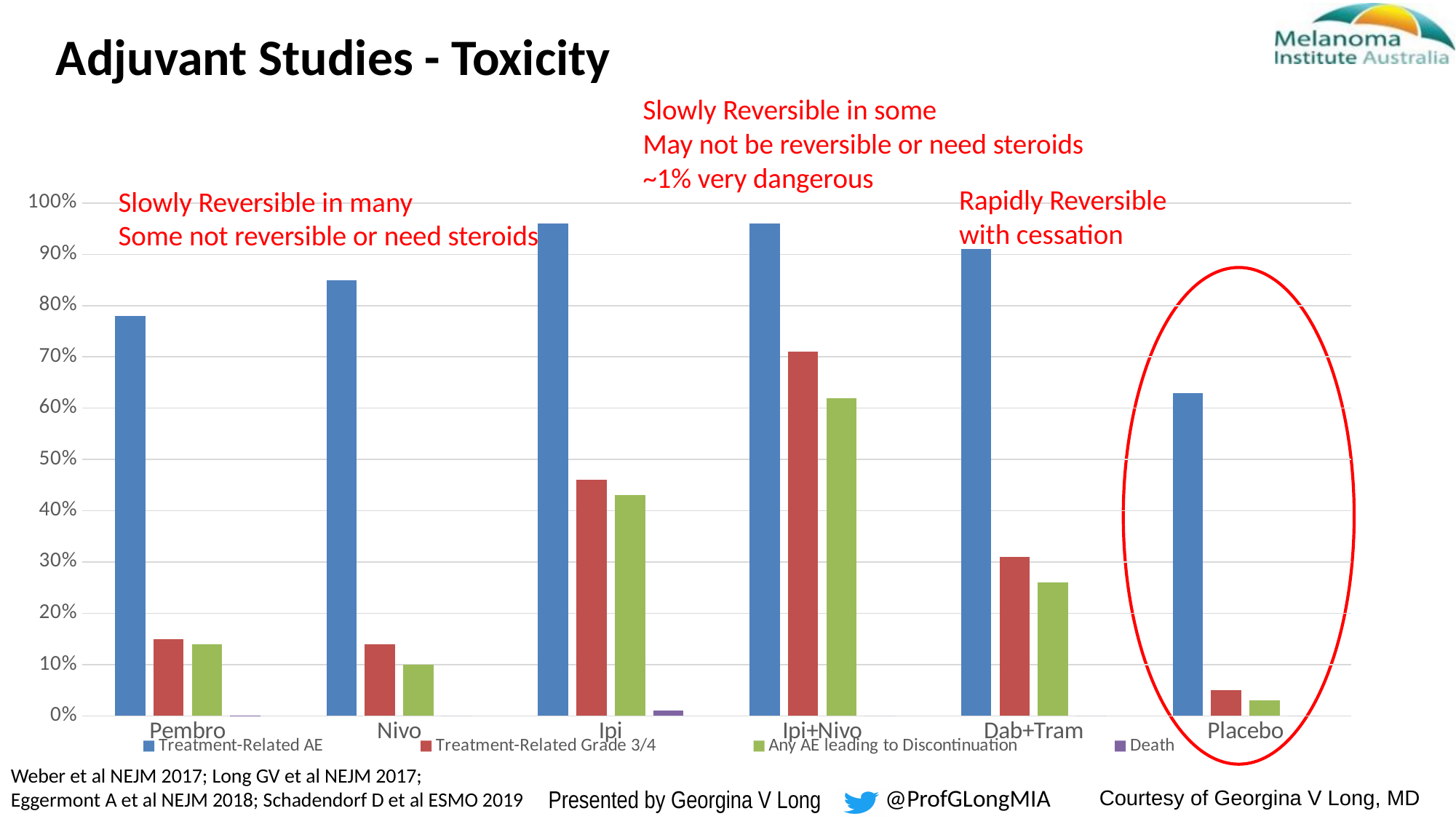
Which category has the highest Treatment-Related Grade 3/4 value? Ipi+Nivo Which category has the highest value for Any AE leading to Discontinuation? Ipi+Nivo Is the Treatment-Related Grade 3/4 value for Pembro greater or less than 20%? less Which category has the lowest Treatment-Related AE value? Placebo How many treatment categories are shown on the x axis? 6 Which is larger, the Treatment-Related AE value for Nivo or for Pembro? Nivo Is the Treatment-Related AE value for Placebo greater or less than 60%? greater Which is larger, the Any AE leading to Discontinuation value for Ipi or for Dab+Tram? Ipi What kind of chart is shown on the slide? bar chart How many series does the legend list? 4 What is the title of the slide? Adjuvant Studies - Toxicity